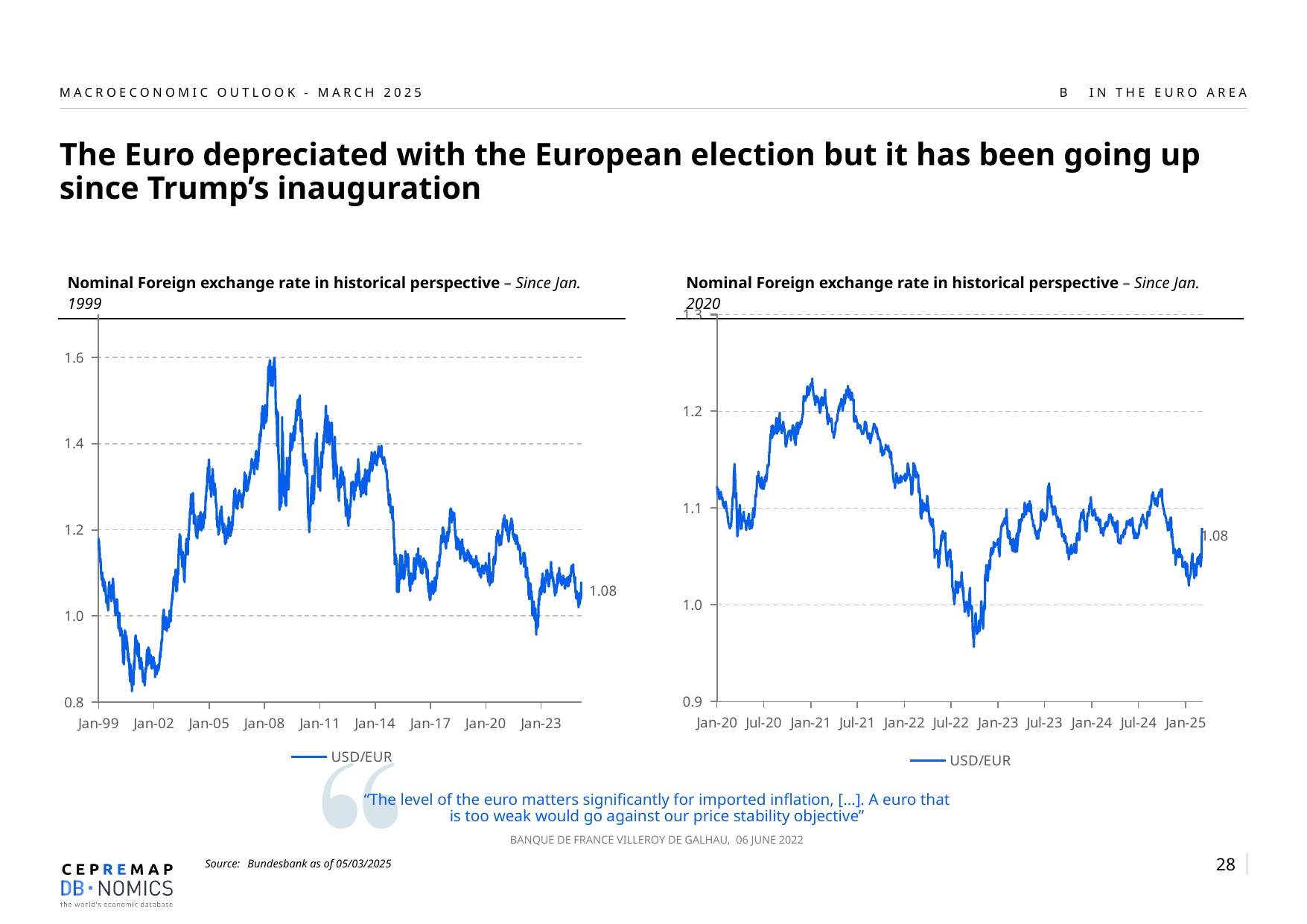
What is the lowest value shown on the y axis of the right chart (since Jan. 2020)? 0.9 In the right chart (since Jan. 2020), what is the latest value labelled at the end of the USD/EUR line? 1.08 What kind of chart is the left chart, 'Nominal Foreign exchange rate in historical perspective – Since Jan. 1999'? line chart What kind of chart is the right chart, 'Nominal Foreign exchange rate in historical perspective – Since Jan. 2020'? line chart In the left chart (since Jan. 1999), is the lowest value of USD/EUR, reached around 2000-2001, greater or less than 1.0? less What series name is shown in the legend of the right chart (since Jan. 2020)? USD/EUR In the right chart (since Jan. 2020), is the lowest value of USD/EUR, reached in late 2022, greater or less than 1.0? less In the right chart (since Jan. 2020), did the USD/EUR rate rise or fall between Jan-21 and Jul-22? fall How many series does the legend of the left chart (since Jan. 1999) list? 1 In the right chart (since Jan. 2020), is the peak value of USD/EUR in early 2021 greater or less than 1.2? greater In the left chart (since Jan. 1999), what is the latest value labelled at the end of the USD/EUR line? 1.08